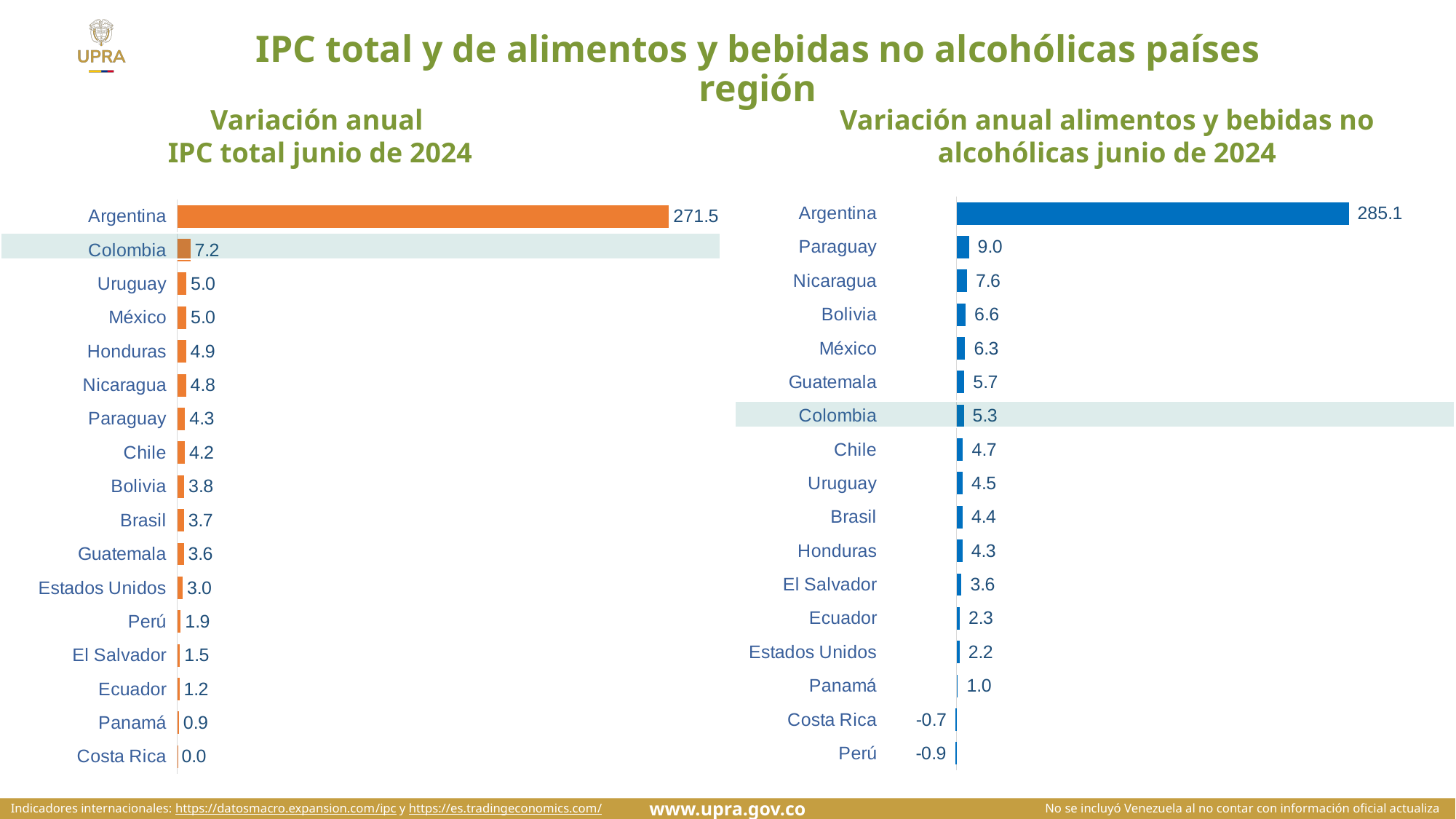
What colour are the bars in the chart 'Variación anual IPC total junio de 2024'? Orange In the chart 'Variación anual IPC total junio de 2024', what is the difference between the values for Argentina and Colombia? 264.3 In the chart 'Variación anual alimentos y bebidas no alcohólicas junio de 2024', which is larger, the value for Bolivia or the value for Brasil? Bolivia In the chart 'Variación anual IPC total junio de 2024', which country has the highest value? Argentina In the chart 'Variación anual alimentos y bebidas no alcohólicas junio de 2024', what is the difference between the values for Nicaragua and Colombia? 2.3 What kind of chart is 'Variación anual alimentos y bebidas no alcohólicas junio de 2024'? Bar chart In the chart 'Variación anual IPC total junio de 2024', which country has the lowest value? Costa Rica In the chart 'Variación anual alimentos y bebidas no alcohólicas junio de 2024', which country has the lowest value? Perú In the chart 'Variación anual IPC total junio de 2024', which is larger, the value for Honduras or the value for Chile? Honduras How many countries are shown in the chart 'Variación anual IPC total junio de 2024'? 17 In the chart 'Variación anual IPC total junio de 2024', what is the value for Colombia? 7.2 In the chart 'Variación anual alimentos y bebidas no alcohólicas junio de 2024', what is the value for Paraguay? 9.0